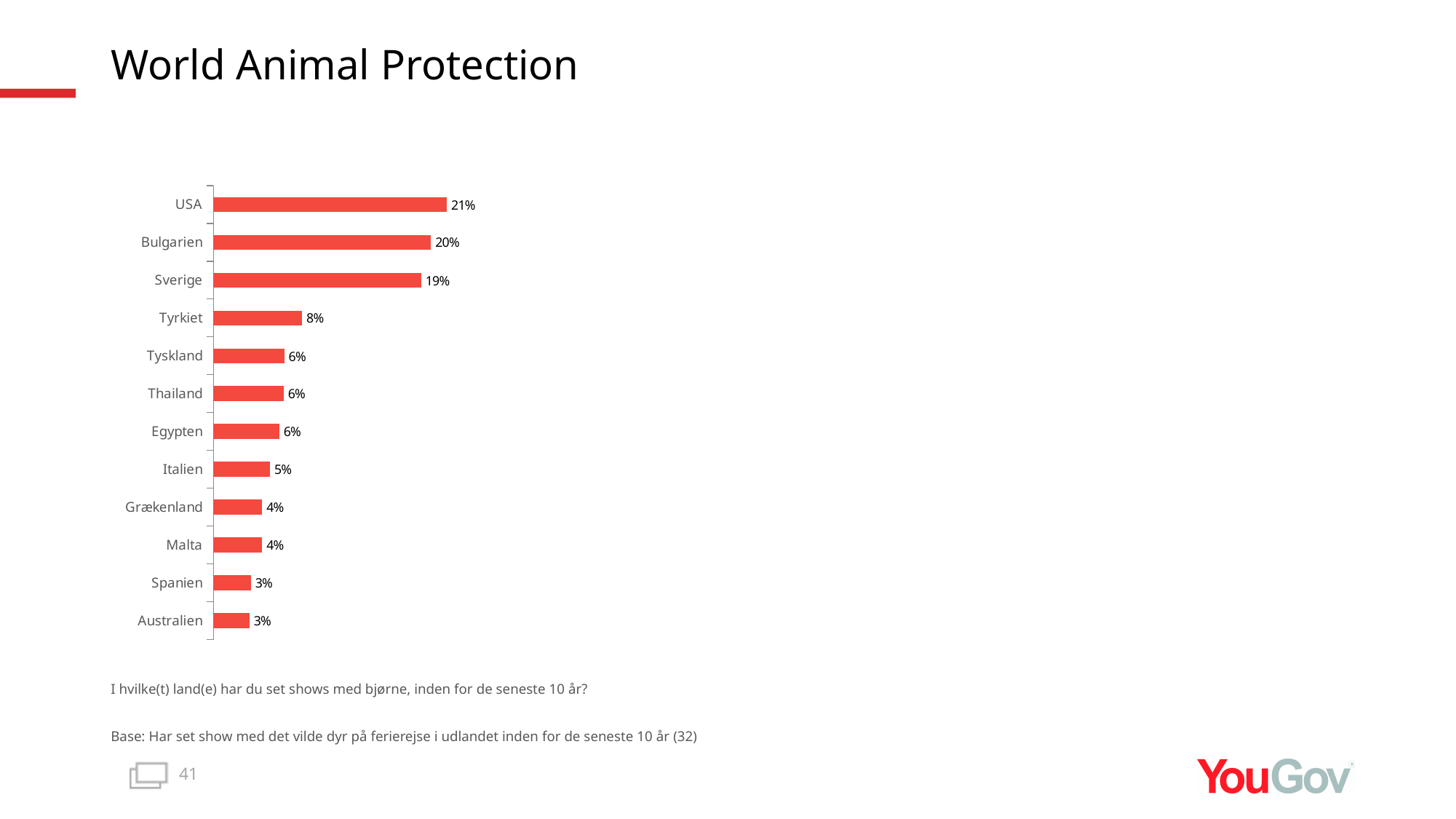
What kind of chart is shown on the slide? Bar chart Which is larger, the value for Bulgarien or the value for Tyskland? Bulgarien Which is larger, the value for Grækenland or the value for Tyrkiet? Tyrkiet What is the value for Italien? 5% What is the value for USA? 21% What is the value for Sverige? 19% What is the difference between the values for USA and Sverige? 2% Which country has the highest value? USA What colour are the bars in the chart? Red How many countries are shown in the chart? 12 What is the value for Tyrkiet? 8% What is the difference between the values for Bulgarien and Tyrkiet? 12%